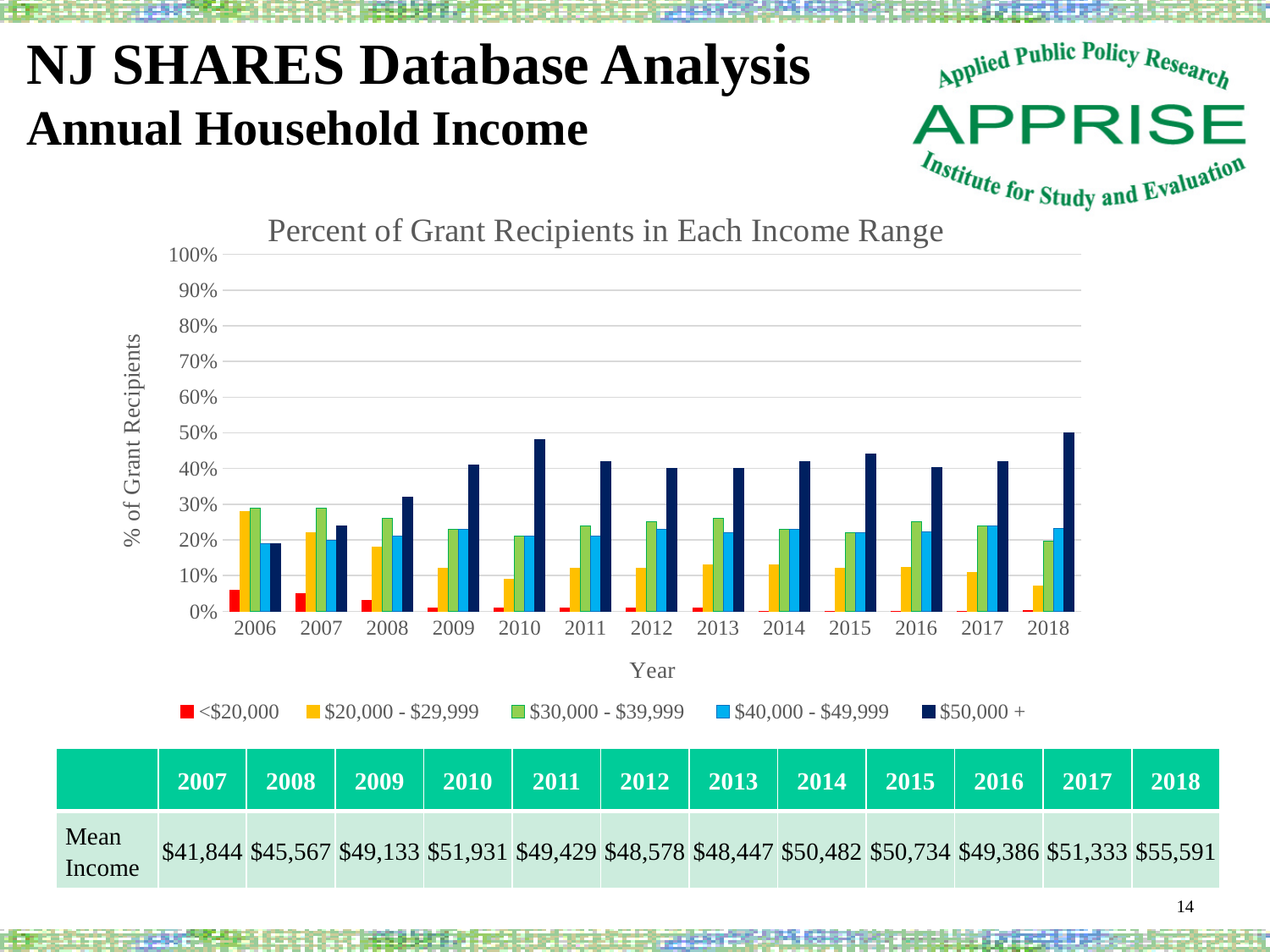
How many years are shown along the x axis of the chart? 13 Does the value for $50,000 + rise or fall from 2006 to 2010? Rise Is the value for $50,000 + in 2006 greater or less than 30%? less Does the value for <$20,000 rise or fall from 2006 to 2018? Fall In 2018, which income range has the shortest bar? <$20,000 What kind of chart is shown on the slide? Bar chart What is the title of the chart? Percent of Grant Recipients in Each Income Range How many income ranges does the chart legend list? 5 In 2018, which income range has the tallest bar? $50,000 + In 2006, which is larger: the value for $20,000 - $29,999 or the value for $50,000 +? $20,000 - $29,999 Is the value for $20,000 - $29,999 in 2006 greater or less than 20%? greater Is the value for $50,000 + in 2018 greater or less than 40%? greater